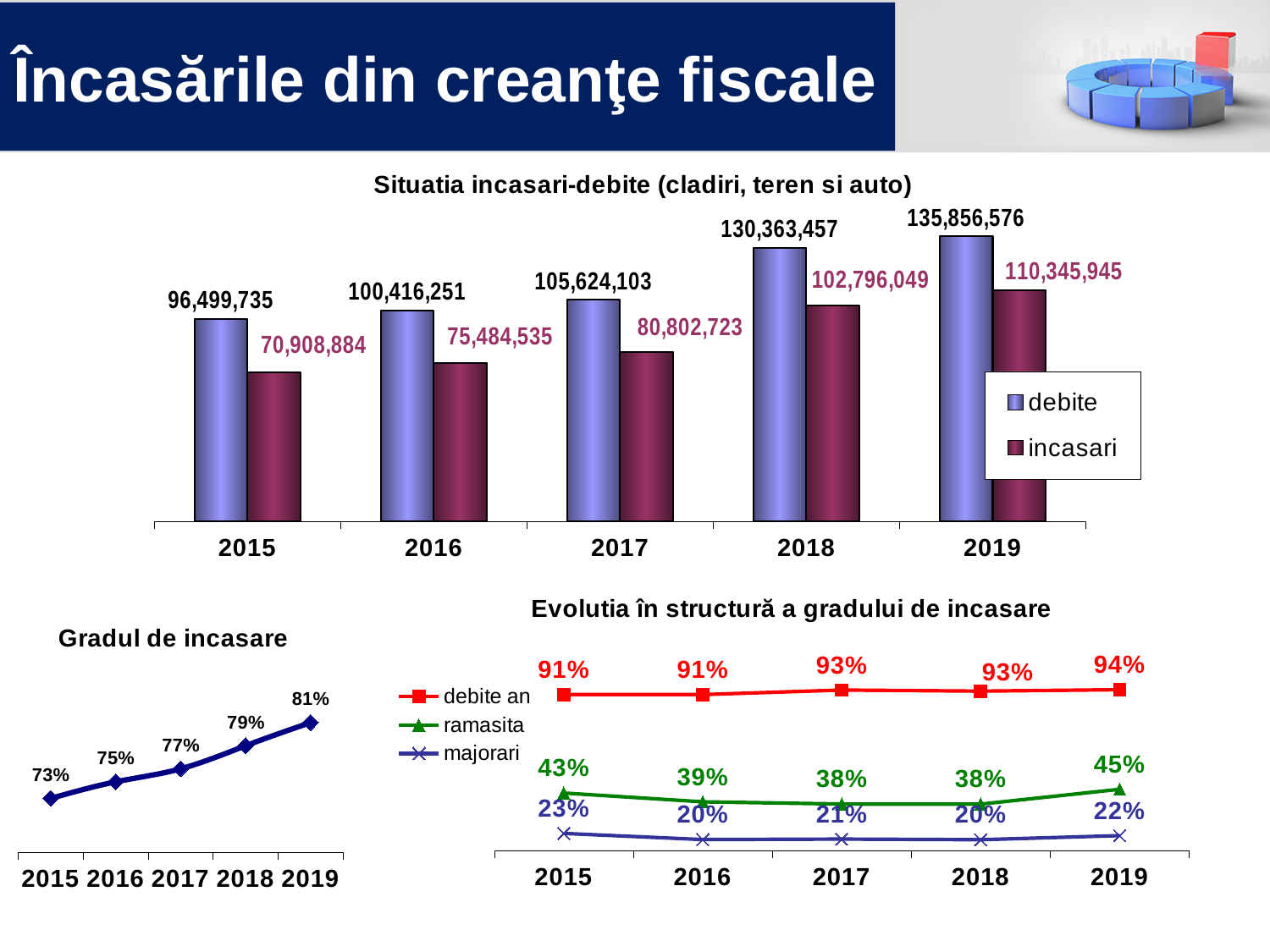
In the chart 'Situatia incasari-debite (cladiri, teren si auto)', what is the difference between debite and incasari in 2019? 25,510,631 In the chart 'Gradul de incasare', do the values rise or fall from 2015 to 2019? rise In the chart 'Evolutia în structură a gradului de incasare', which year has the lowest majorari value? 2016 and 2018 In the chart 'Situatia incasari-debite (cladiri, teren si auto)', what is the value of incasari for 2016? 75,484,535 In the chart 'Gradul de incasare', what is the value for 2017? 77% In the chart 'Evolutia în structură a gradului de incasare', what is the value of ramasita for 2019? 45% In the chart 'Gradul de incasare', what is the difference between the 2019 and 2015 values? 8% In the chart 'Situatia incasari-debite (cladiri, teren si auto)', which year has the highest incasari value? 2019 In the chart 'Evolutia în structură a gradului de incasare', how many series does the legend list? 3 What type of chart is 'Situatia incasari-debite (cladiri, teren si auto)'? bar chart In the chart 'Situatia incasari-debite (cladiri, teren si auto)', what is the value of debite for 2018? 130,363,457 In the chart 'Situatia incasari-debite (cladiri, teren si auto)', how many series does the legend list? 2